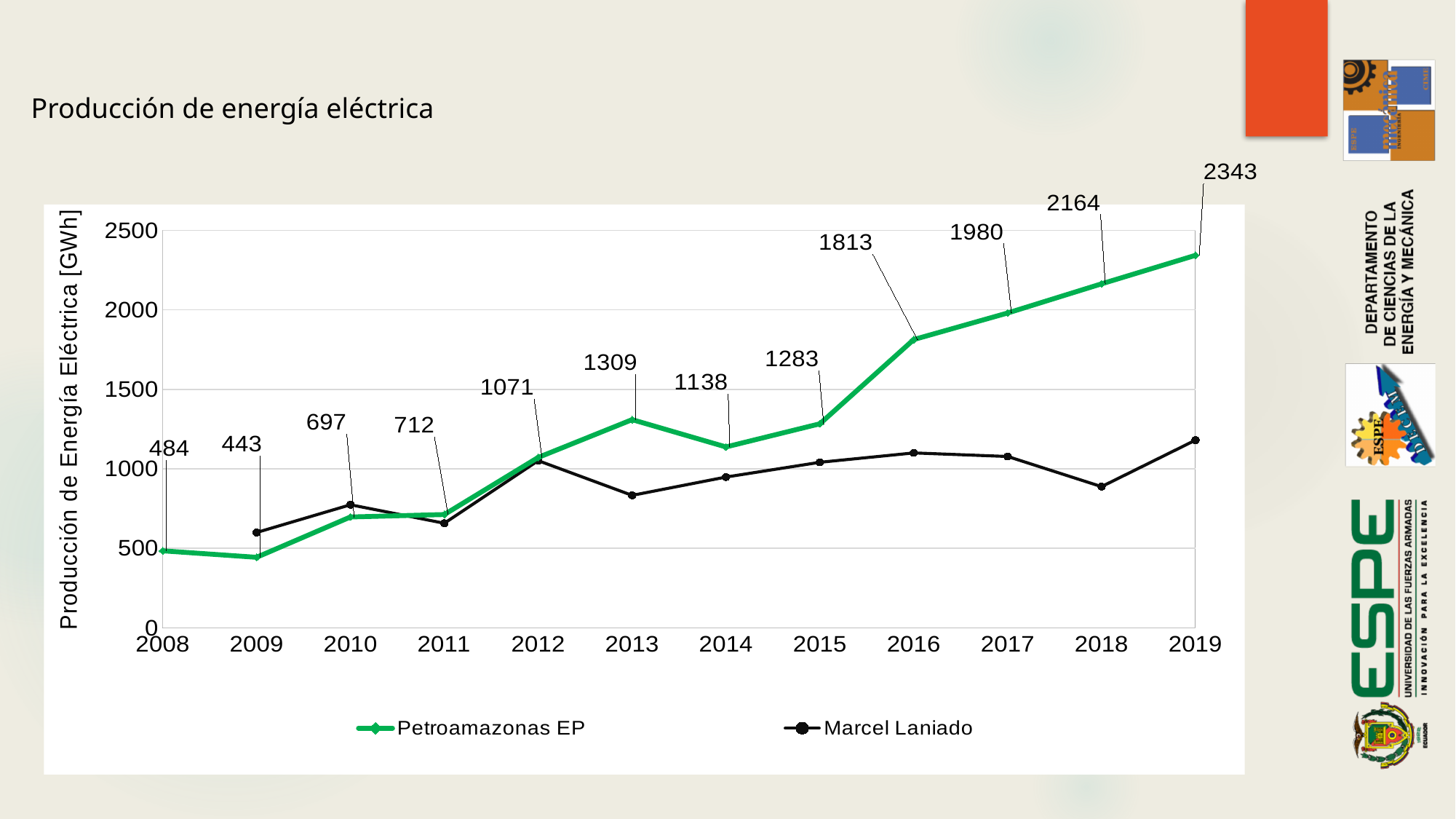
What was the Petroamazonas EP production in 2009? 443 In which year did Petroamazonas EP reach its highest production? 2019 Is the Marcel Laniado value for 2019 greater or less than 1000? greater By how much did Petroamazonas EP production increase from 2018 to 2019? 179 How many years are shown on the x axis of the chart? 12 How many series does the legend list? 2 Is the Marcel Laniado value for 2018 greater or less than 1000? less What was the electricity production of Petroamazonas EP in 2019? 2343 What is the difference between the Petroamazonas EP values for 2013 and 2014? 171 What value is shown for Petroamazonas EP in 2012? 1071 In which year was the Petroamazonas EP production lowest? 2009 Which series had the higher value in 2017, Petroamazonas EP or Marcel Laniado? Petroamazonas EP